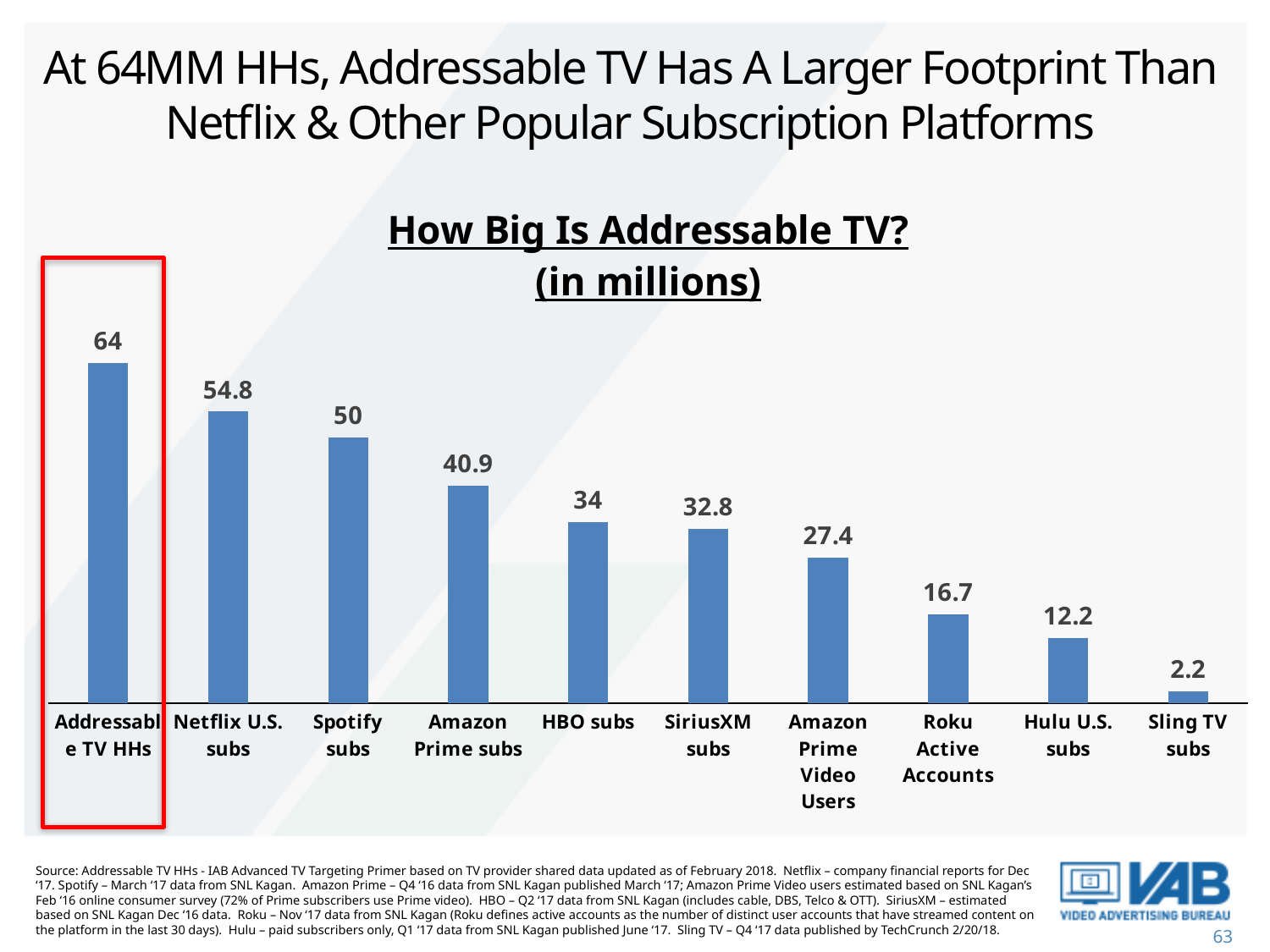
What kind of chart is shown on the slide? Bar chart What is the value for Netflix U.S. subs? 54.8 What is the difference between Addressable TV HHs and Netflix U.S. subs? 9.2 What is the title of the chart? How Big Is Addressable TV? (in millions) Which category has the lowest value? Sling TV subs Do the values rise or fall from left to right across the categories? Fall Which is larger, SiriusXM subs or Hulu U.S. subs? SiriusXM subs What is the value for Amazon Prime Video Users? 27.4 Which category has the highest value? Addressable TV HHs What is the difference between Spotify subs and HBO subs? 16 How many categories are shown in the chart? 10 What is the value for Roku Active Accounts? 16.7